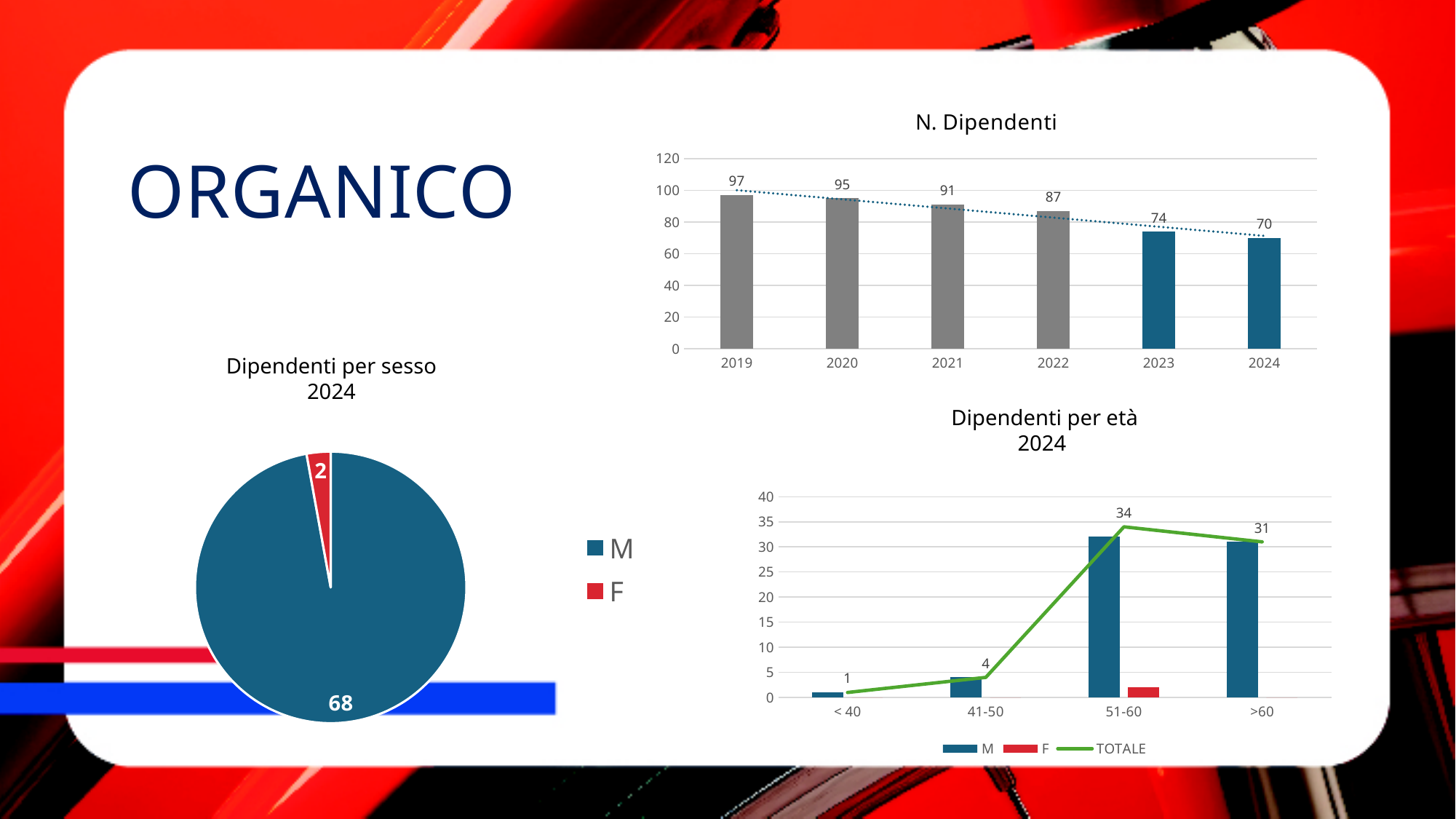
In the 'Dipendenti per sesso 2024' pie chart, what is the value for F? 2 In the 'N. Dipendenti' chart, how many years are shown on the x axis? 6 In the 'N. Dipendenti' chart, what is the value for 2024? 70 In the 'N. Dipendenti' chart, which year has the lowest value? 2024 In the 'N. Dipendenti' chart, do the values rise or fall from 2019 to 2024? fall In the 'Dipendenti per età 2024' chart, is the M bar for 51-60 greater or less than 30? greater In the 'Dipendenti per sesso 2024' pie chart, what is the value for M? 68 In the 'N. Dipendenti' chart, what is the value for 2019? 97 In the 'Dipendenti per età 2024' chart, what is the TOTALE value for the 51-60 category? 34 In the 'N. Dipendenti' chart, what is the difference between the values for 2019 and 2024? 27 In the 'Dipendenti per età 2024' chart, how many series does the legend list? 3